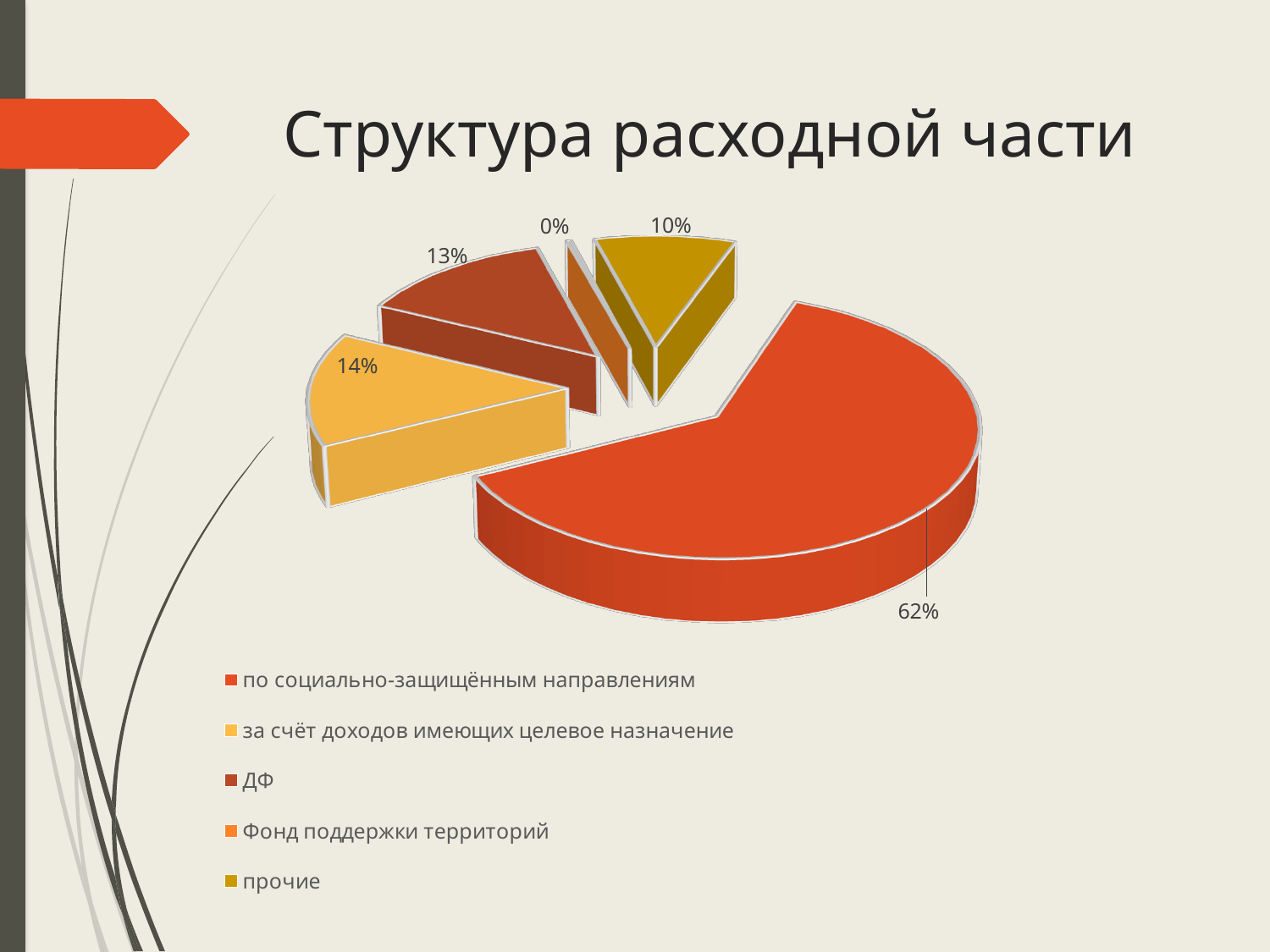
What share of the pie is labelled for "по социально-защищённым направлениям"? 62% What is the title of the chart? Структура расходной части Which category has the smallest share of the pie? Фонд поддержки территорий What share of the pie is labelled for "прочие"? 10% Which category has the largest share of the pie? по социально-защищённым направлениям How many categories does the legend list? 5 What share of the pie is labelled for "ДФ"? 13% Which is larger, the share for "ДФ" or the share for "прочие"? ДФ What kind of chart is shown on the slide? pie chart What is the difference in percentage points between the share for "по социально-защищённым направлениям" and the share for "за счёт доходов имеющих целевое назначение"? 48